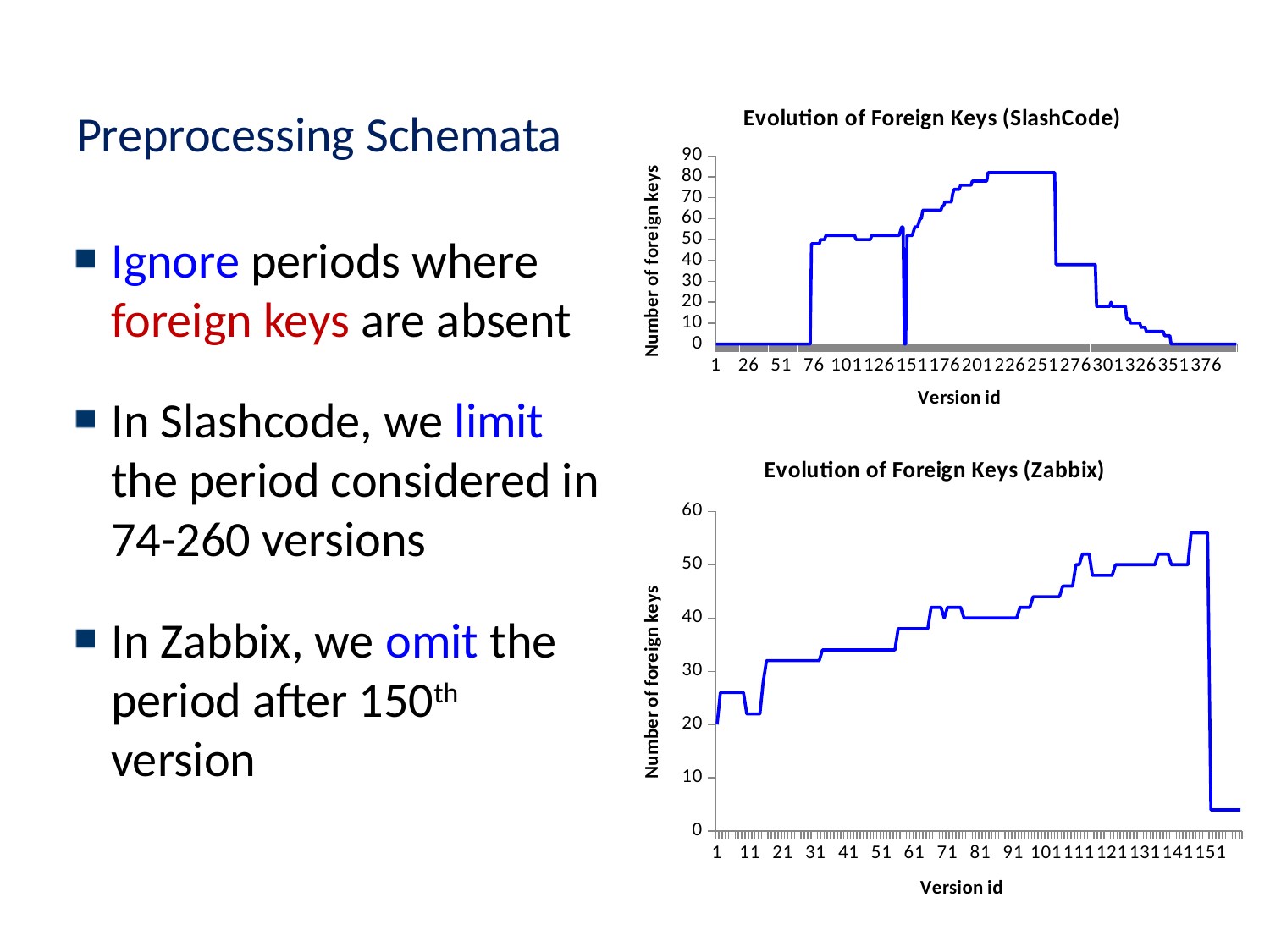
In the 'Evolution of Foreign Keys (SlashCode)' chart, is the value at version id 226 greater or less than 70? greater What kind of chart is the 'Evolution of Foreign Keys (Zabbix)' chart? line chart Which chart reaches a higher peak number of foreign keys, the SlashCode chart or the Zabbix chart? SlashCode What kind of chart is the 'Evolution of Foreign Keys (SlashCode)' chart? line chart In the 'Evolution of Foreign Keys (SlashCode)' chart, do the values rise or fall between version id 276 and version id 351? fall What is the label of the vertical axis on the 'Evolution of Foreign Keys (Zabbix)' chart? Number of foreign keys In the 'Evolution of Foreign Keys (Zabbix)' chart, is the value at version id 141 greater or less than 40? greater In the 'Evolution of Foreign Keys (Zabbix)' chart, is the value at version id 21 greater or less than 40? less In the 'Evolution of Foreign Keys (Zabbix)' chart, do the values generally rise or fall between version id 1 and version id 141? rise